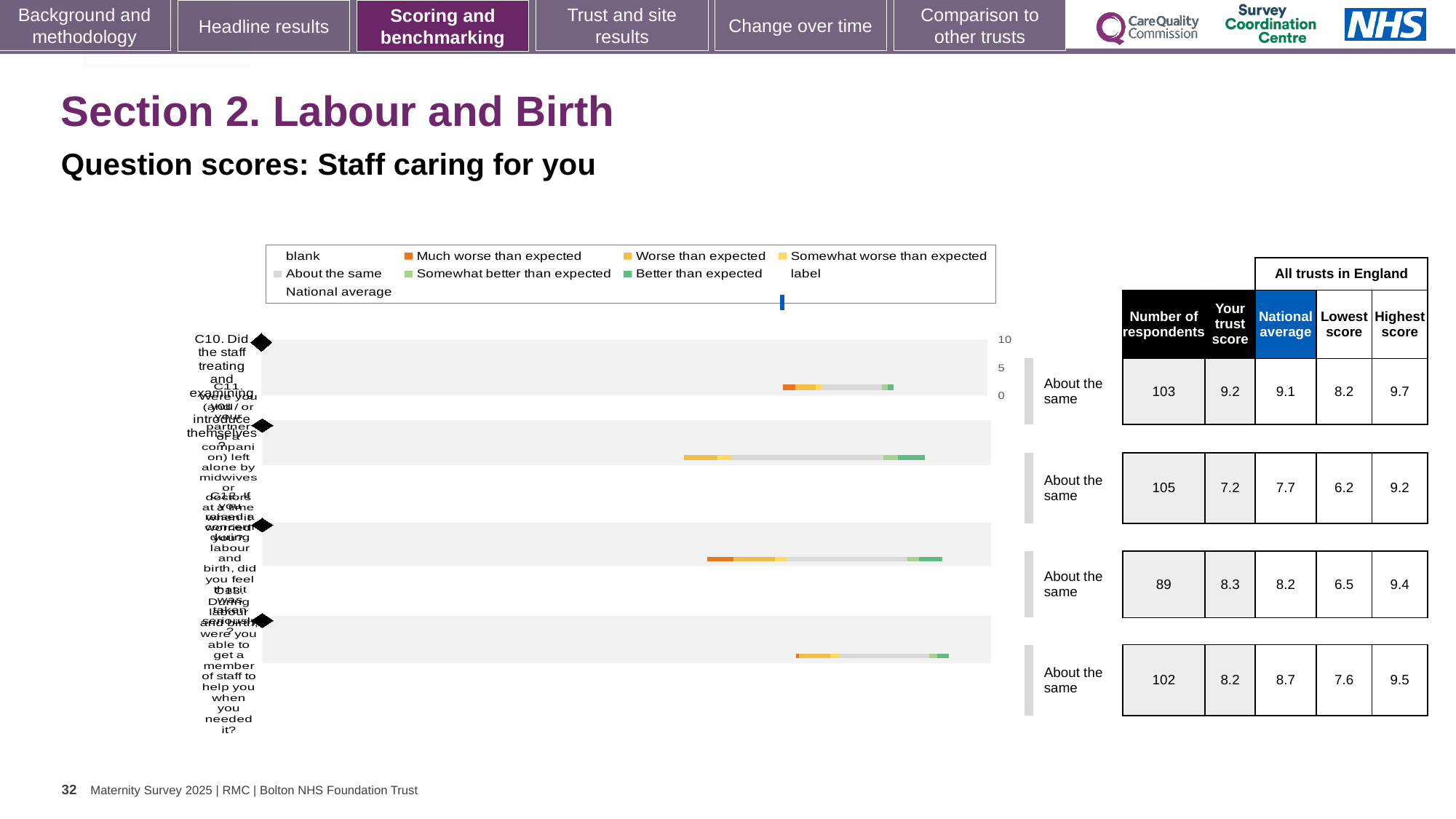
How many question bars are plotted in the chart? 4 In the table, what is the difference between the highest score and the lowest score in the third row? 2.9 In the table, what is the lowest score in the fourth row? 7.6 In the table, what is the national average in the second row? 7.7 Which legend entry is shown in dark orange? Much worse than expected What kind of chart is shown on the slide? bar chart In the first row of the table, which is larger: your trust score or the national average? Your trust score In the second row of the table, which is larger: your trust score or the national average? National average In the table, what is the 'Your trust score' value in the first row? 9.2 What benchmark label is shown next to each of the four bars? About the same In the table, what is the number of respondents in the first row? 103 Which row of the table has the highest number of respondents? second row (105)